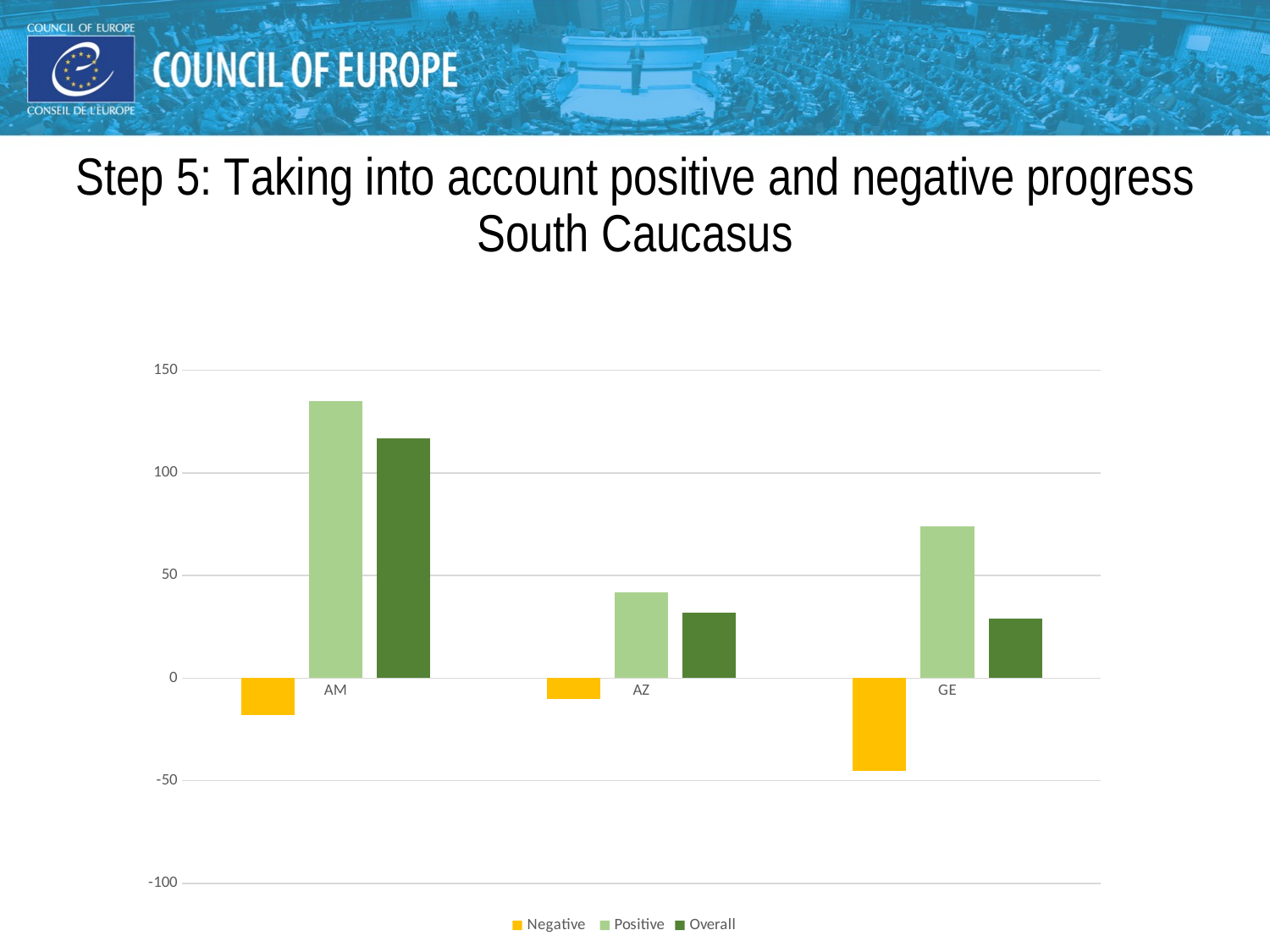
Is the Positive value for AM greater or less than 100? greater Is the Overall value for AM greater or less than 100? greater Which category has the lowest Negative value? GE Is the Positive value for GE greater or less than 50? greater How many categories are shown on the x axis of the chart? 3 Which series is shown in yellow in the chart's legend? Negative Which category has the highest Positive value? AM What kind of chart is shown on the slide? bar chart Which category has the lowest Positive value? AZ Which is larger, the Overall value for AM or the Overall value for AZ? AM How many series does the chart's legend list? 3